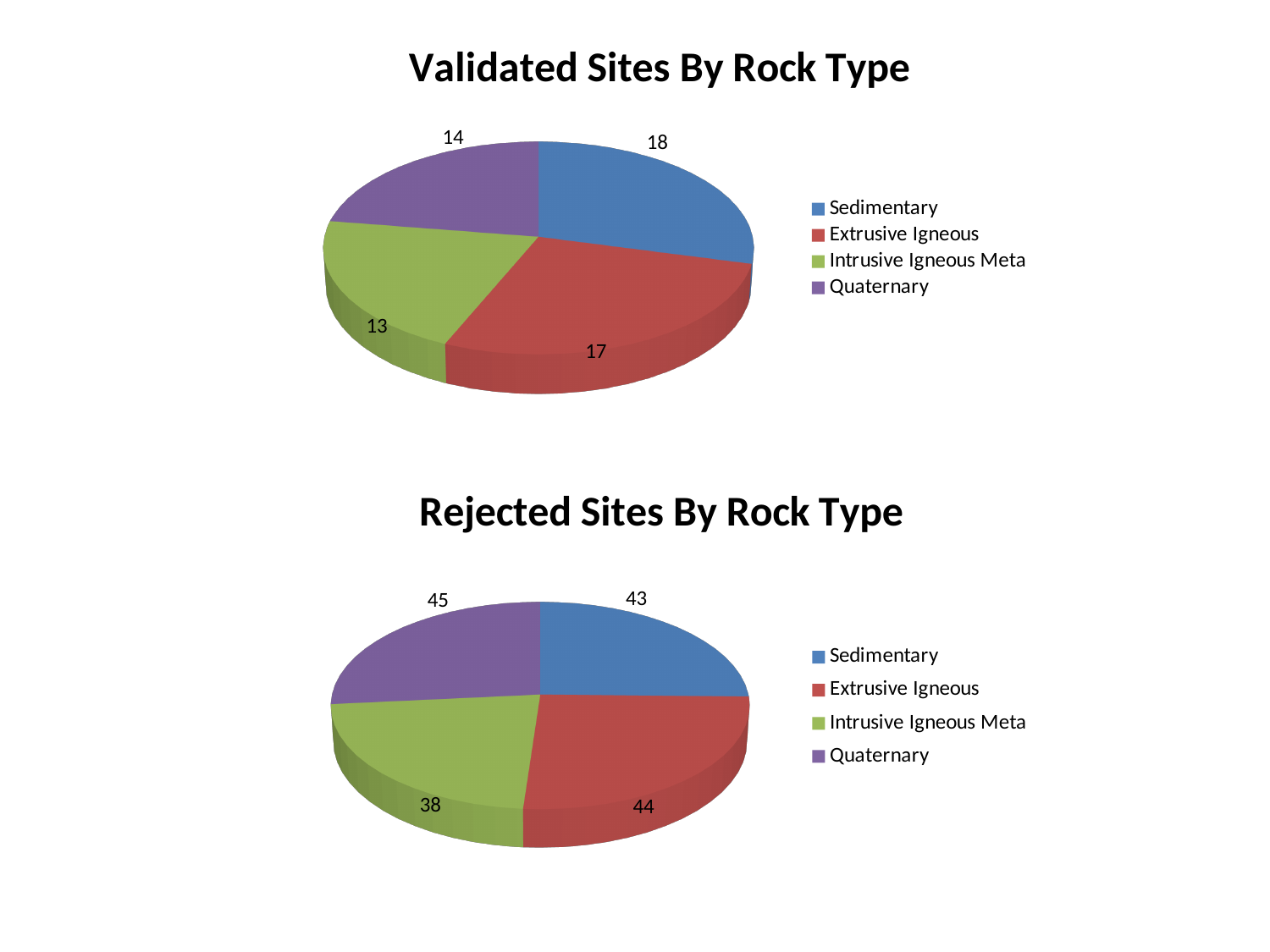
In the Validated Sites By Rock Type chart, which is larger: Quaternary or Intrusive Igneous Meta? Quaternary In the Rejected Sites By Rock Type chart, which rock type has the smallest slice? Intrusive Igneous Meta In the Rejected Sites By Rock Type chart, what is the value for Quaternary? 45 In the Rejected Sites By Rock Type chart, what is the difference between the Quaternary and Intrusive Igneous Meta values? 7 In the Validated Sites By Rock Type chart, what is the value for Intrusive Igneous Meta? 13 In the Validated Sites By Rock Type chart, which rock type has the largest slice? Sedimentary In the Validated Sites By Rock Type chart, how many validated sites are Sedimentary? 18 How many rock types does the legend of the Rejected Sites By Rock Type chart list? 4 What kind of chart is the Validated Sites By Rock Type chart? Pie chart In the Rejected Sites By Rock Type chart, which rock type has the largest slice? Quaternary In the Rejected Sites By Rock Type chart, what is the value for Extrusive Igneous? 44 In the Validated Sites By Rock Type chart, which rock type has the smallest slice? Intrusive Igneous Meta